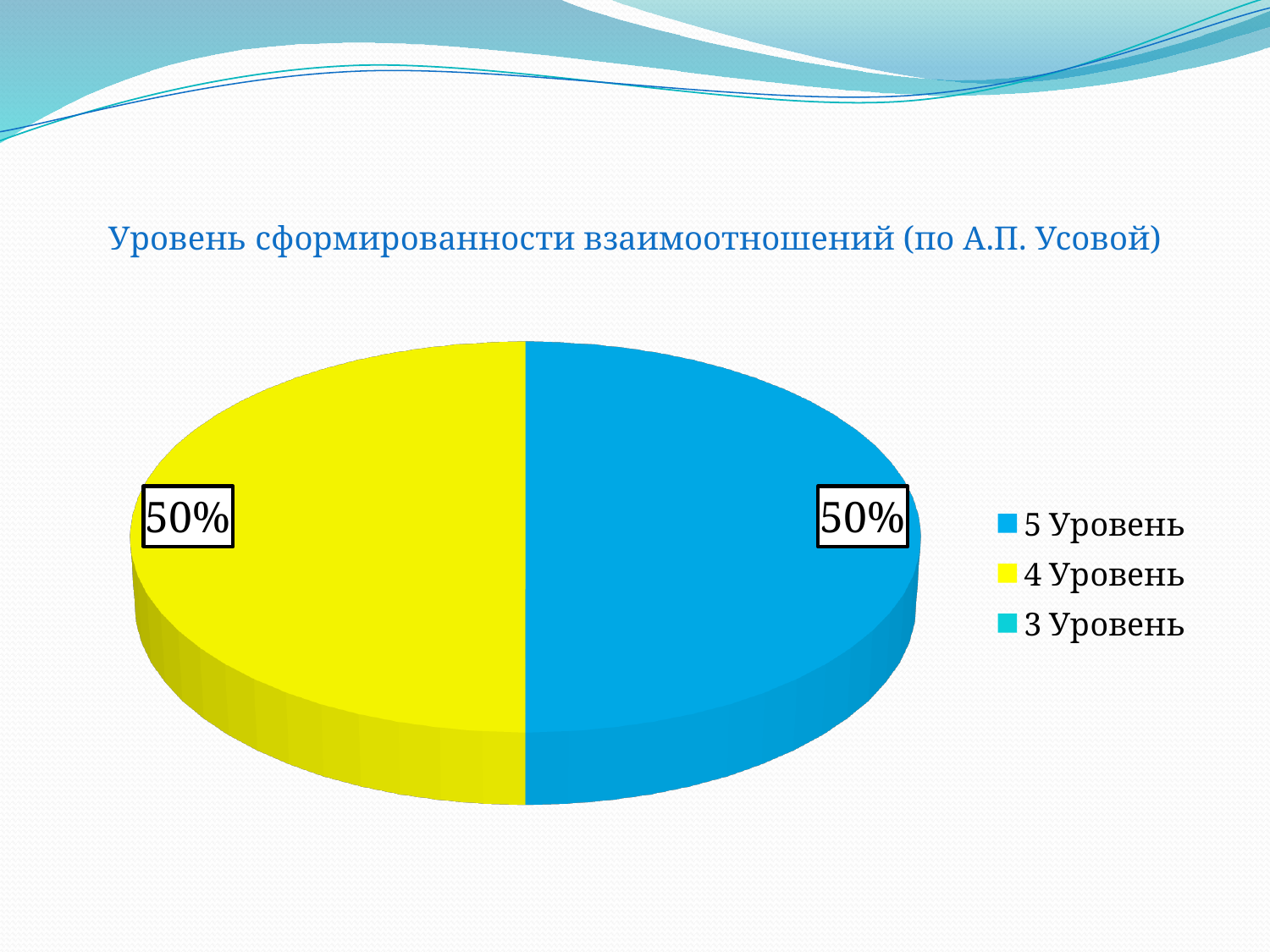
What kind of chart is shown on the slide? pie chart What percentage of the pie is labelled for 5 Уровень? 50% What percentage of the pie is labelled for 4 Уровень? 50% What is the title of the chart? Уровень сформированности взаимоотношений (по А.П. Усовой) How many entries does the legend list? 3 What do the two labelled slices (5 Уровень and 4 Уровень) add up to? 100% What share of the pie does the blue slice (5 Уровень) take? 50% Which colour represents 4 Уровень in the legend? yellow How many slices with data labels are visible in the pie? 2